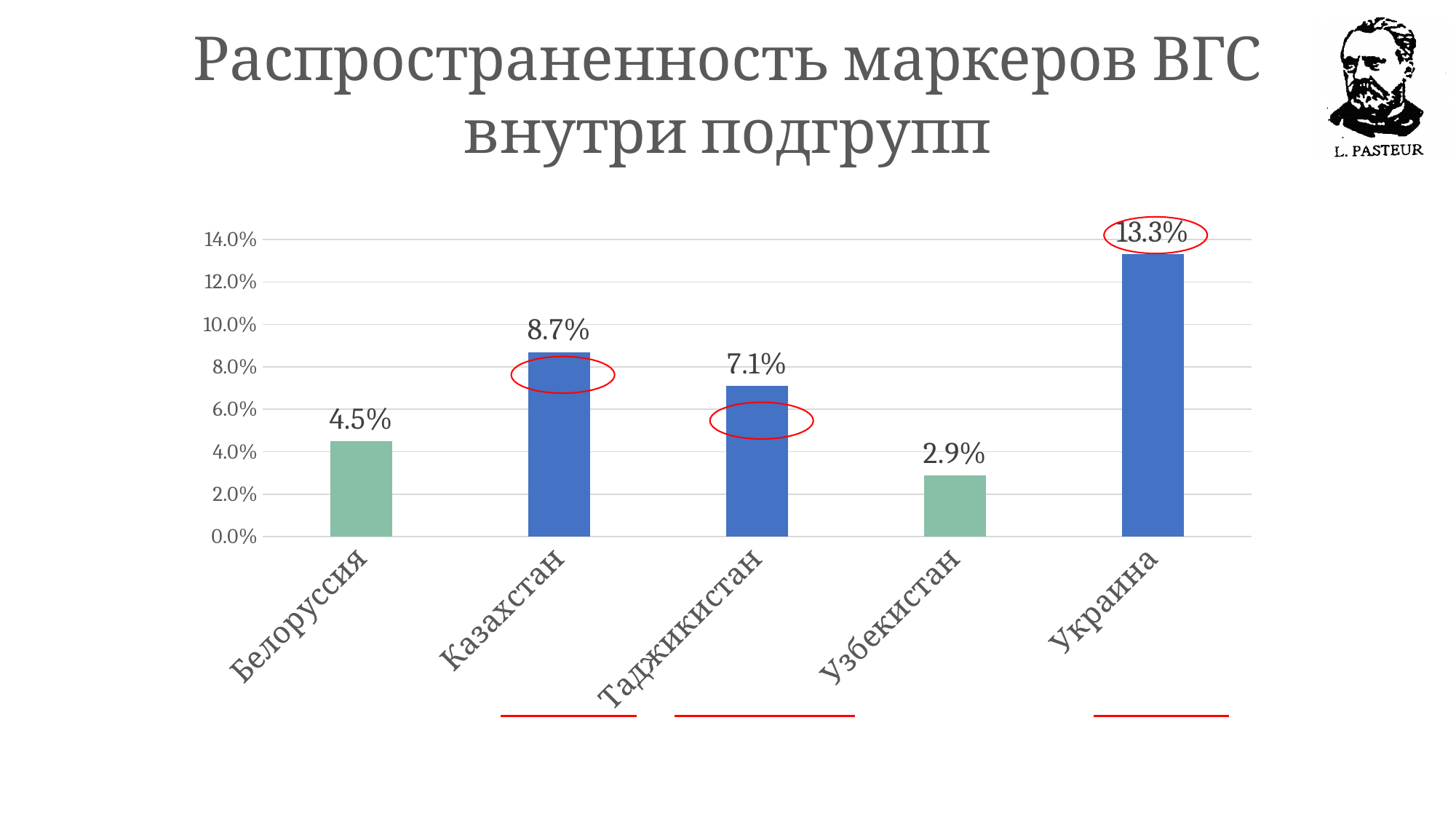
What is the value for Белоруссия? 4.5% What is the value for Узбекистан? 2.9% Which country has the lowest value? Узбекистан What kind of chart is shown on the slide? bar chart What is the value for Казахстан? 8.7% What is the value for Украина? 13.3% What is the difference between the values for Белоруссия and Узбекистан? 1.6% Which country has the highest value? Украина How many countries are shown on the chart? 5 Which is larger, the value for Таджикистан or the value for Белоруссия? Таджикистан Is the value for Таджикистан greater or less than 6.0%? greater What is the difference between the values for Украина and Казахстан? 4.6%